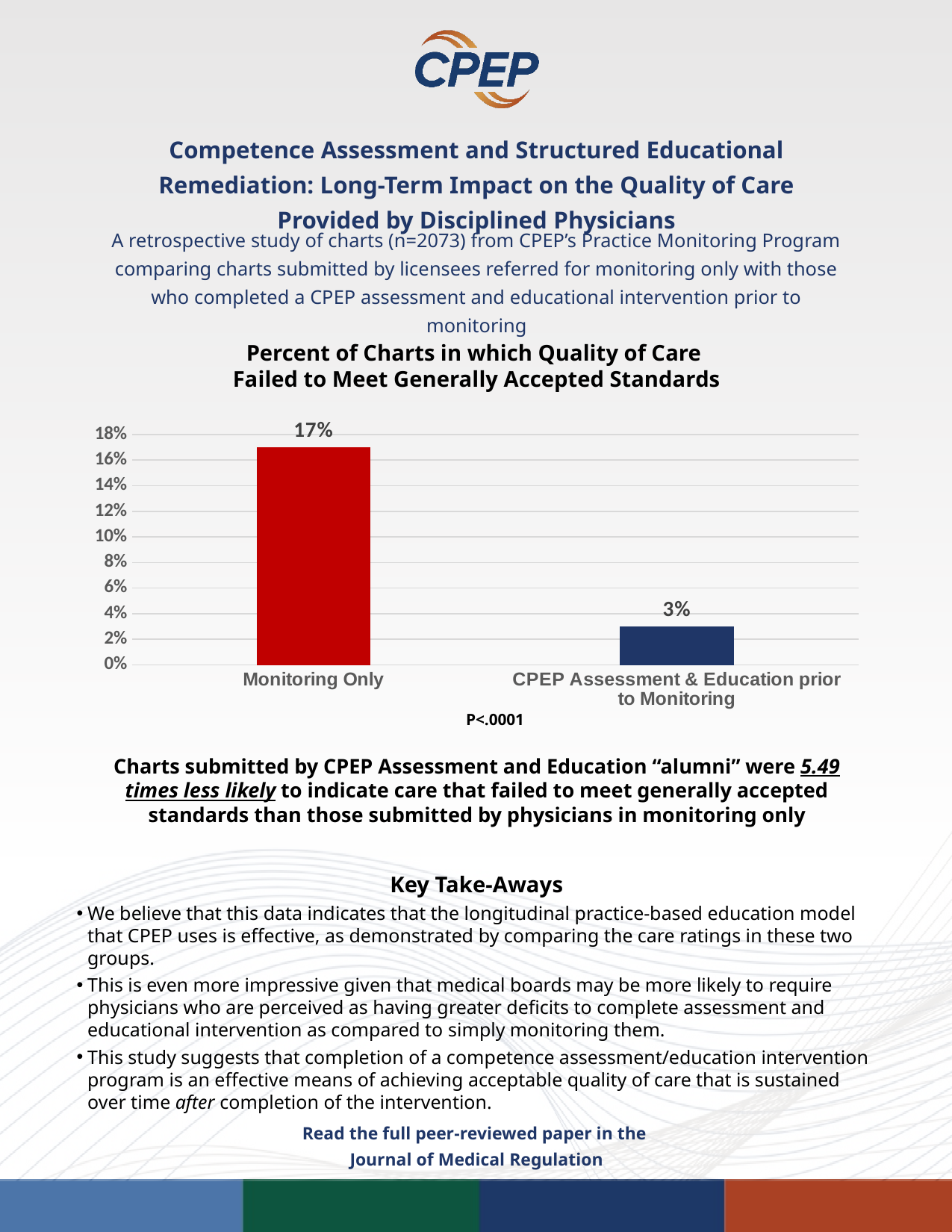
What colour is the bar for Monitoring Only? Red Is the value for Monitoring Only greater or less than 10%? greater What is the title of the chart? Percent of Charts in which Quality of Care Failed to Meet Generally Accepted Standards What kind of chart is shown on the slide? Bar chart Which category has the lowest percentage of charts failing to meet standards? CPEP Assessment & Education prior to Monitoring Which is larger: the value for Monitoring Only or the value for CPEP Assessment & Education prior to Monitoring? Monitoring Only Is the value for CPEP Assessment & Education prior to Monitoring greater or less than 6%? less Which category has the highest percentage of charts failing to meet standards? Monitoring Only What is the difference between the Monitoring Only value and the CPEP Assessment & Education prior to Monitoring value? 14% What is the value for CPEP Assessment & Education prior to Monitoring? 3% What is the value for Monitoring Only? 17% How many categories are shown in the chart? 2